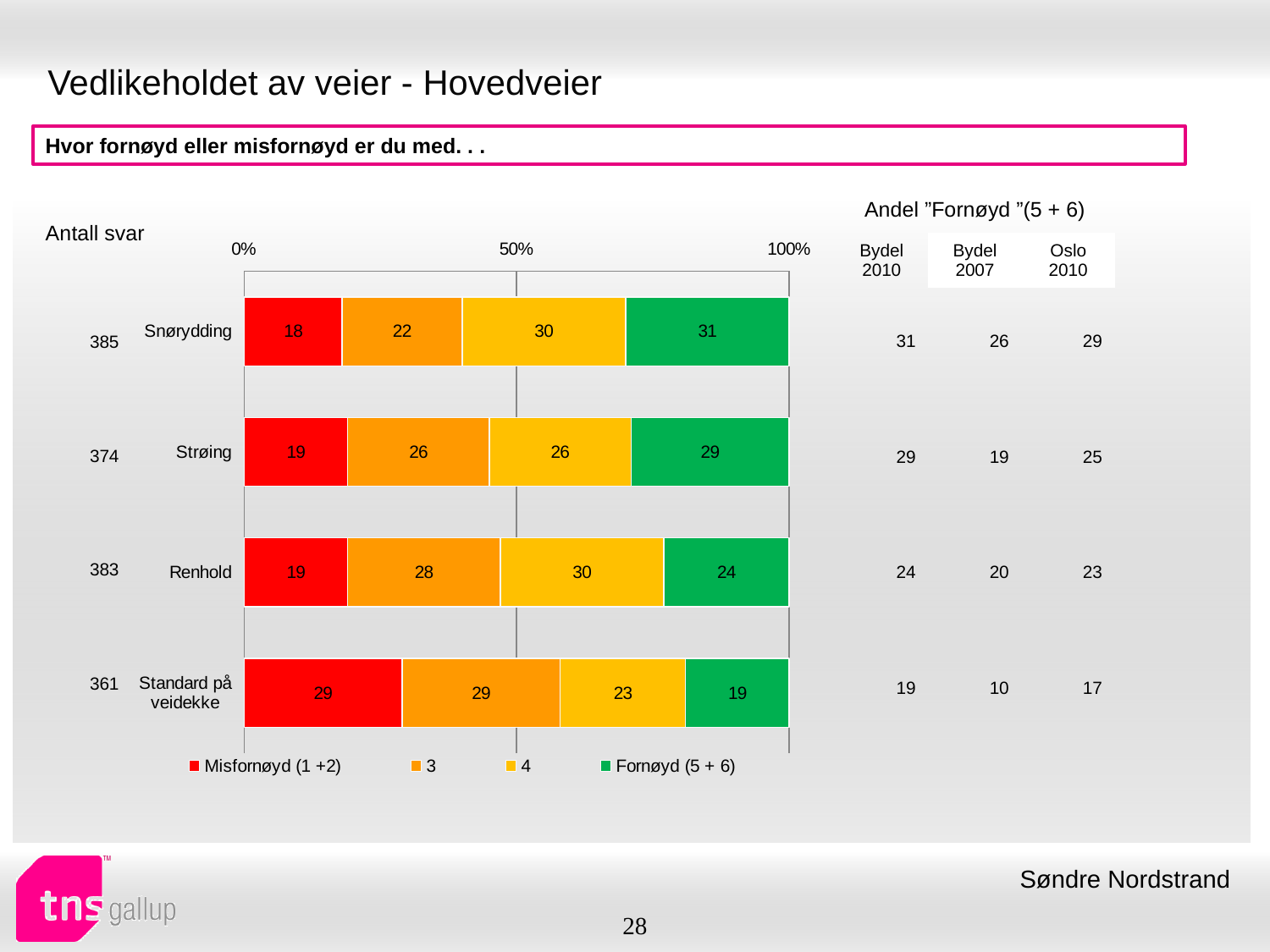
How many categories are shown in the chart? 4 Which category has the lowest Fornøyd (5 + 6) value? Standard på veidekke What is the difference between the Misfornøyd (1 +2) values for Standard på veidekke and Snørydding? 11 How many series does the legend list? 4 What kind of chart is shown on the slide? Stacked bar chart What is the value of the Fornøyd (5 + 6) segment for Snørydding? 31 Which is larger: the '4' segment for Strøing or the '4' segment for Renhold? Renhold What is the total of the stacked bar for Strøing? 100 What is the value of the '3' segment for Renhold? 28 Which category has the highest Fornøyd (5 + 6) value? Snørydding What colour represents the Fornøyd (5 + 6) series in the chart? Green What is the value of the Misfornøyd (1 +2) segment for Standard på veidekke? 29